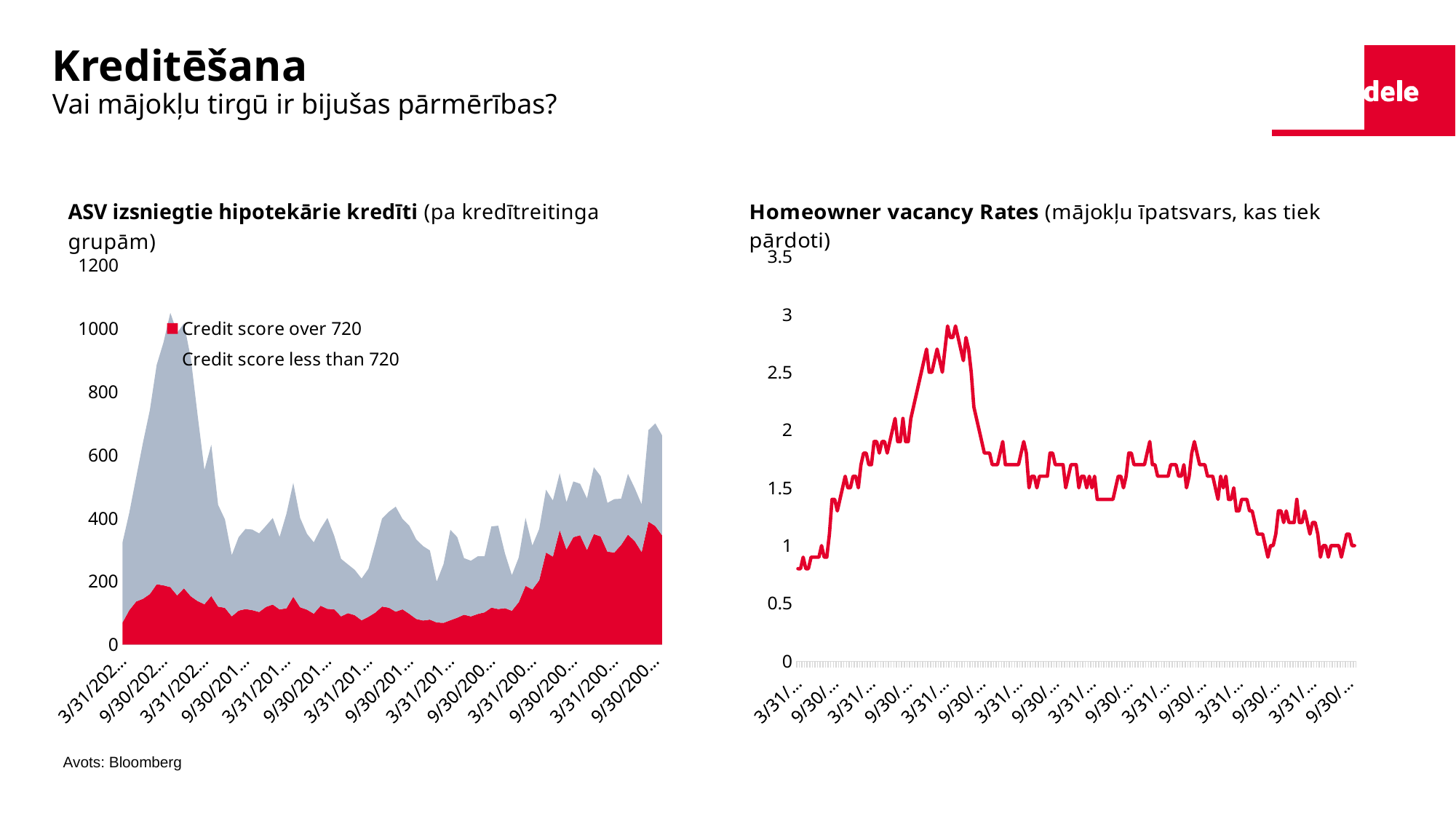
In the right chart 'Homeowner vacancy Rates', is the peak value of the line greater or less than 2.5? greater What is the highest value shown on the vertical axis of the right chart 'Homeowner vacancy Rates'? 3.5 How many series does the legend of the left chart 'ASV izsniegtie hipotekārie kredīti' list? 2 In the right chart 'Homeowner vacancy Rates', is the value at the far right end of the line greater or less than 1.5? less In the left chart 'ASV izsniegtie hipotekārie kredīti', which series is shown in red? Credit score over 720 In the right chart 'Homeowner vacancy Rates', is the peak of the line higher or lower than the value at the far right end? higher What kind of chart is the left chart, 'ASV izsniegtie hipotekārie kredīti'? stacked area chart In the right chart 'Homeowner vacancy Rates', is the value at the far left start of the line greater or less than 1? less What kind of chart is the right chart, 'Homeowner vacancy Rates'? line chart